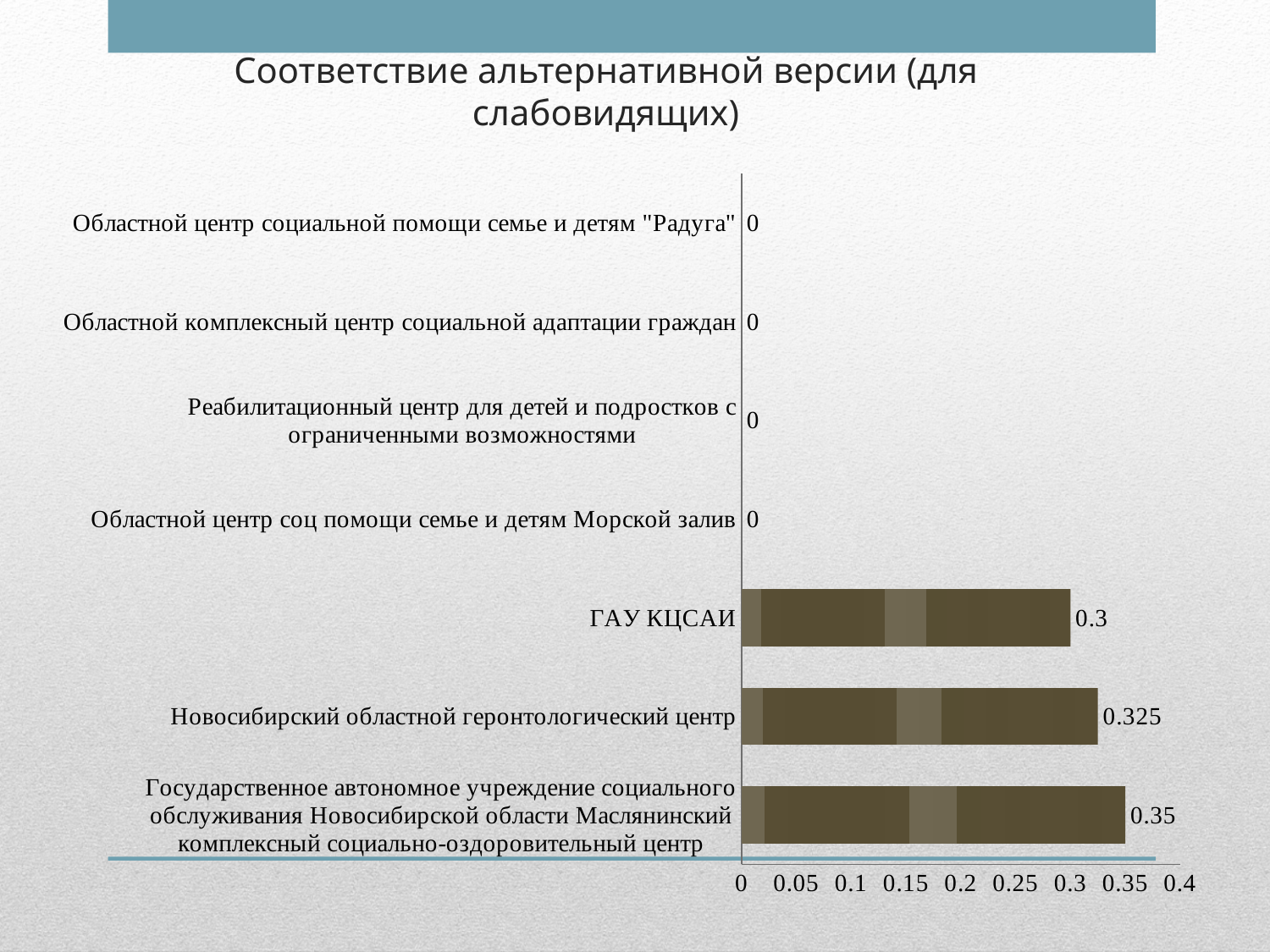
What is the title of the slide? Соответствие альтернативной версии (для слабовидящих) Which is larger, the value for Новосибирский областной геронтологический центр or the value for ГАУ КЦСАИ? Новосибирский областной геронтологический центр What is the value for Областной центр соц помощи семье и детям Морской залив? 0 What is the value for Государственное автономное учреждение социального обслуживания Новосибирской области Маслянинский комплексный социально-оздоровительный центр? 0.35 How many categories are shown on the chart? 7 What kind of chart is shown on the slide? bar chart What is the difference between the values for Новосибирский областной геронтологический центр and ГАУ КЦСАИ? 0.025 What is the value for Новосибирский областной геронтологический центр? 0.325 What is the difference between the values for Маслянинский комплексный социально-оздоровительный центр and ГАУ КЦСАИ? 0.05 Which category has the highest value? Государственное автономное учреждение социального обслуживания Новосибирской области Маслянинский комплексный социально-оздоровительный центр What is the value for ГАУ КЦСАИ? 0.3 Is the value for ГАУ КЦСАИ greater or less than 0.2? greater